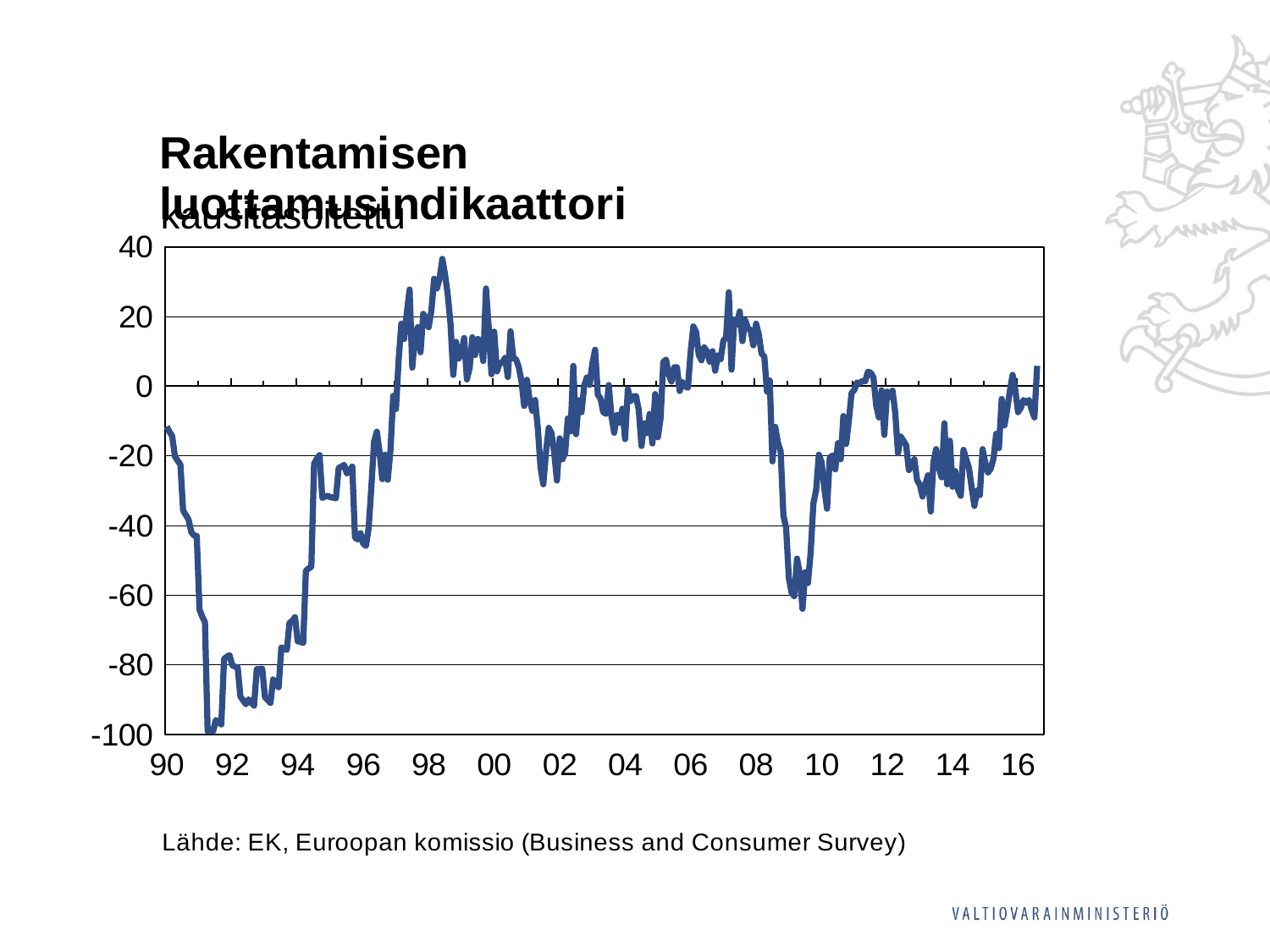
What kind of chart is shown on the slide? line chart Around which year does the indicator reach its lowest point? 1991 What is the title of the chart? Rakentamisen luottamusindikaattori Is the value of the indicator around 1998 greater or less than 20? greater Does the indicator rise or fall between 2008 and 2009? fall Is the value of the indicator around 2007 greater or less than 0? greater Is the value of the indicator around 2009 greater or less than -40? less What is the highest value shown on the vertical axis? 40 Does the indicator rise or fall between 1991 and 1998? rise Around which year does the indicator reach its highest point? 1998